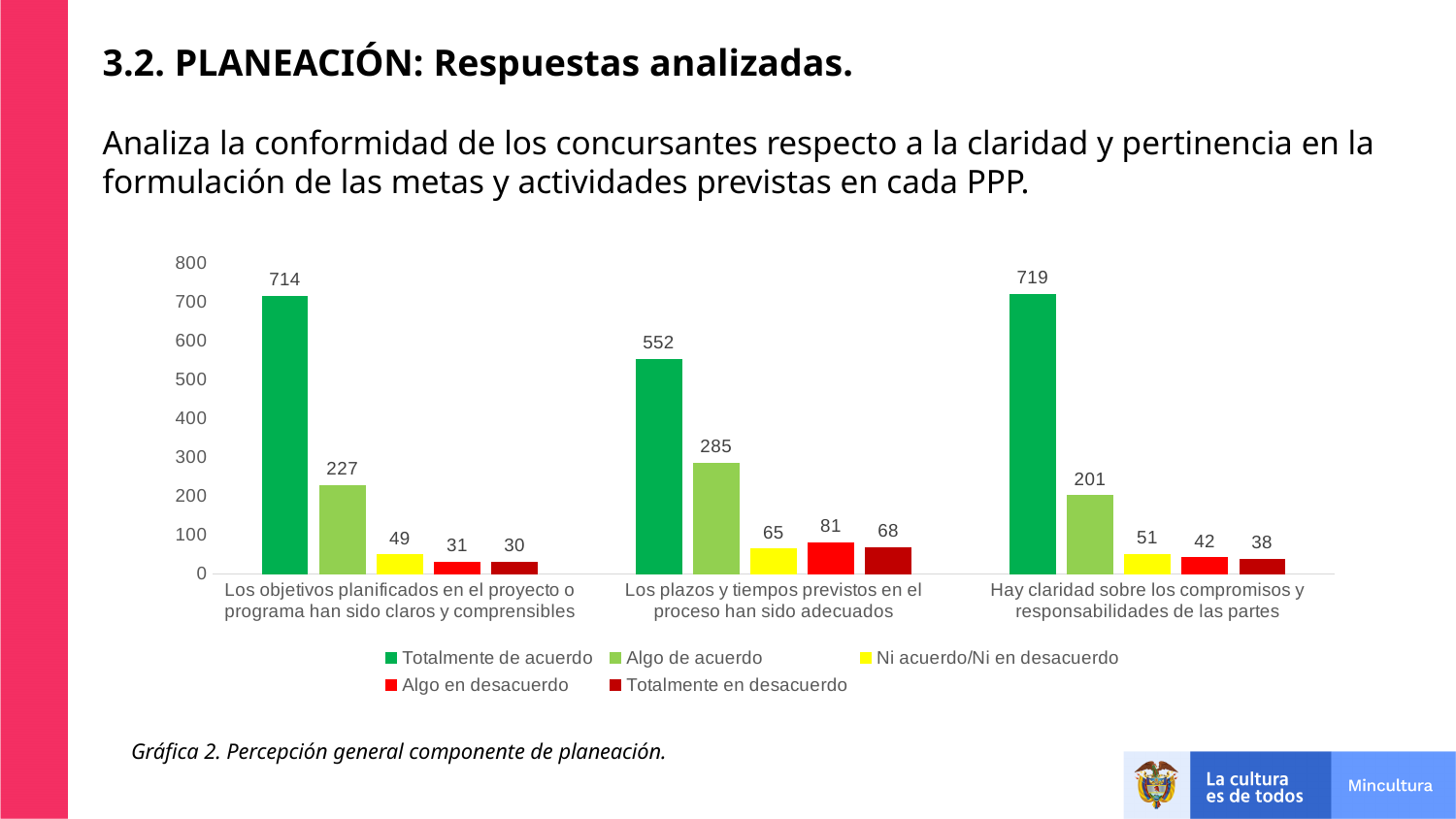
What is the value for "Ni acuerdo/Ni en desacuerdo" in the category "Los objetivos planificados en el proyecto o programa han sido claros y comprensibles"? 49 Which category has the lowest value for "Totalmente en desacuerdo"? Los objetivos planificados en el proyecto o programa han sido claros y comprensibles What is the difference between the "Totalmente de acuerdo" values for "Hay claridad sobre los compromisos y responsabilidades de las partes" and "Los plazos y tiempos previstos en el proceso han sido adecuados"? 167 Which category has the highest value for "Totalmente de acuerdo"? Hay claridad sobre los compromisos y responsabilidades de las partes How many series does the legend list? 5 Which is larger: "Algo en desacuerdo" for "Los plazos y tiempos previstos en el proceso han sido adecuados" or "Algo en desacuerdo" for "Hay claridad sobre los compromisos y responsabilidades de las partes"? Los plazos y tiempos previstos en el proceso han sido adecuados How many categories are shown on the x axis? 3 What kind of chart is shown on the slide? Bar chart What is the value for "Algo de acuerdo" in the category "Hay claridad sobre los compromisos y responsabilidades de las partes"? 201 What is the value for "Totalmente de acuerdo" in the category "Los plazos y tiempos previstos en el proceso han sido adecuados"? 552 Which colour represents "Ni acuerdo/Ni en desacuerdo" in the chart? Yellow Is the value for "Algo de acuerdo" in "Los plazos y tiempos previstos en el proceso han sido adecuados" greater or less than 200? greater